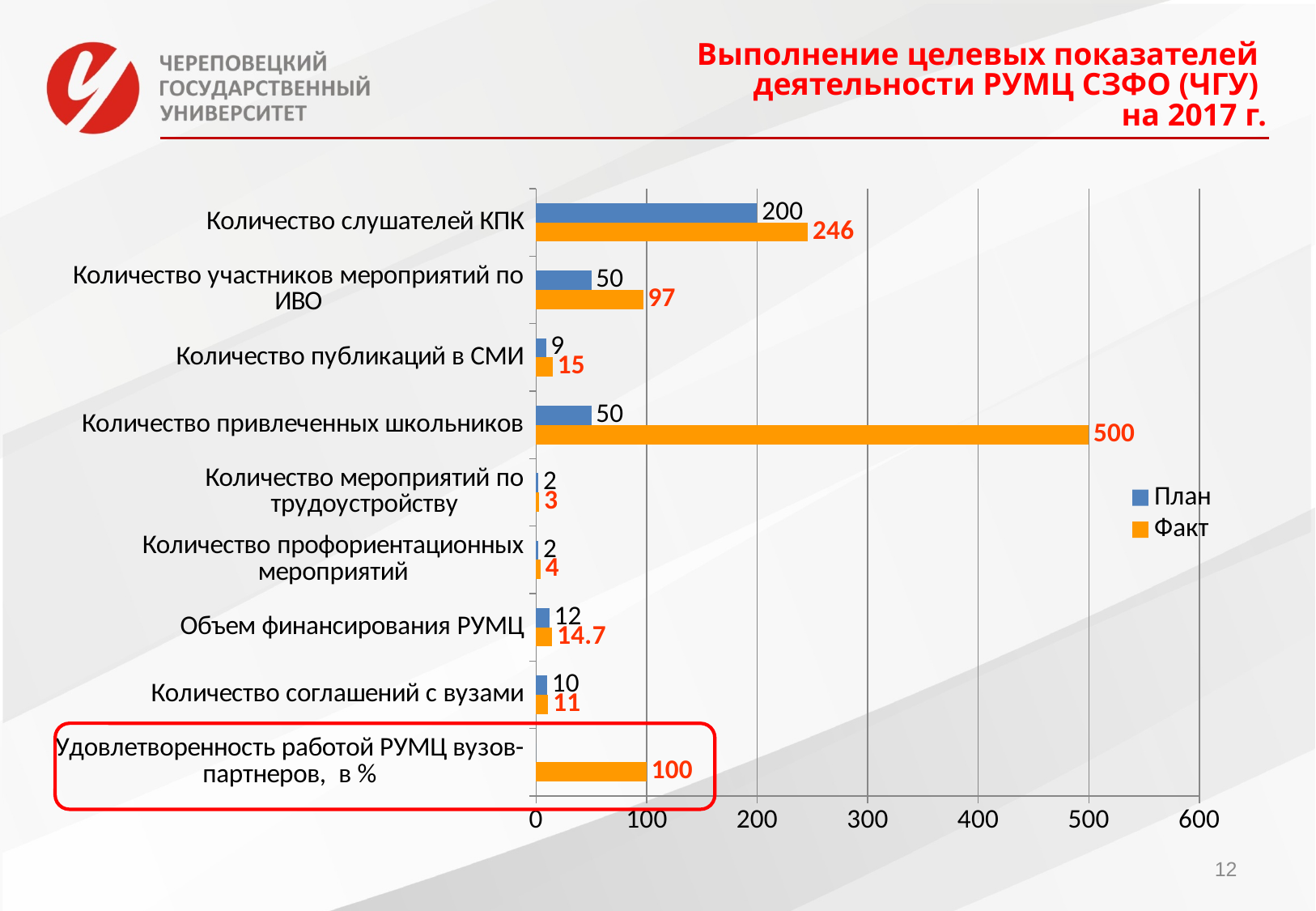
What kind of chart is shown on the slide? Bar chart What is the difference between the Факт and План values for Количество участников мероприятий по ИВО? 47 How many categories are shown on the chart? 9 What is the Факт value for Количество слушателей КПК? 246 Which is larger: the Факт value for Количество слушателей КПК or the Факт value for Количество участников мероприятий по ИВО? Количество слушателей КПК How many series does the legend list? 2 Which category has the lowest Факт value? Количество мероприятий по трудоустройству What is the План value for Количество участников мероприятий по ИВО? 50 Which category has the highest Факт value? Количество привлеченных школьников What is the Факт value for Объем финансирования РУМЦ? 14.7 Which series is shown in orange in the legend? Факт What is the difference between the Факт and План values for Количество привлеченных школьников? 450